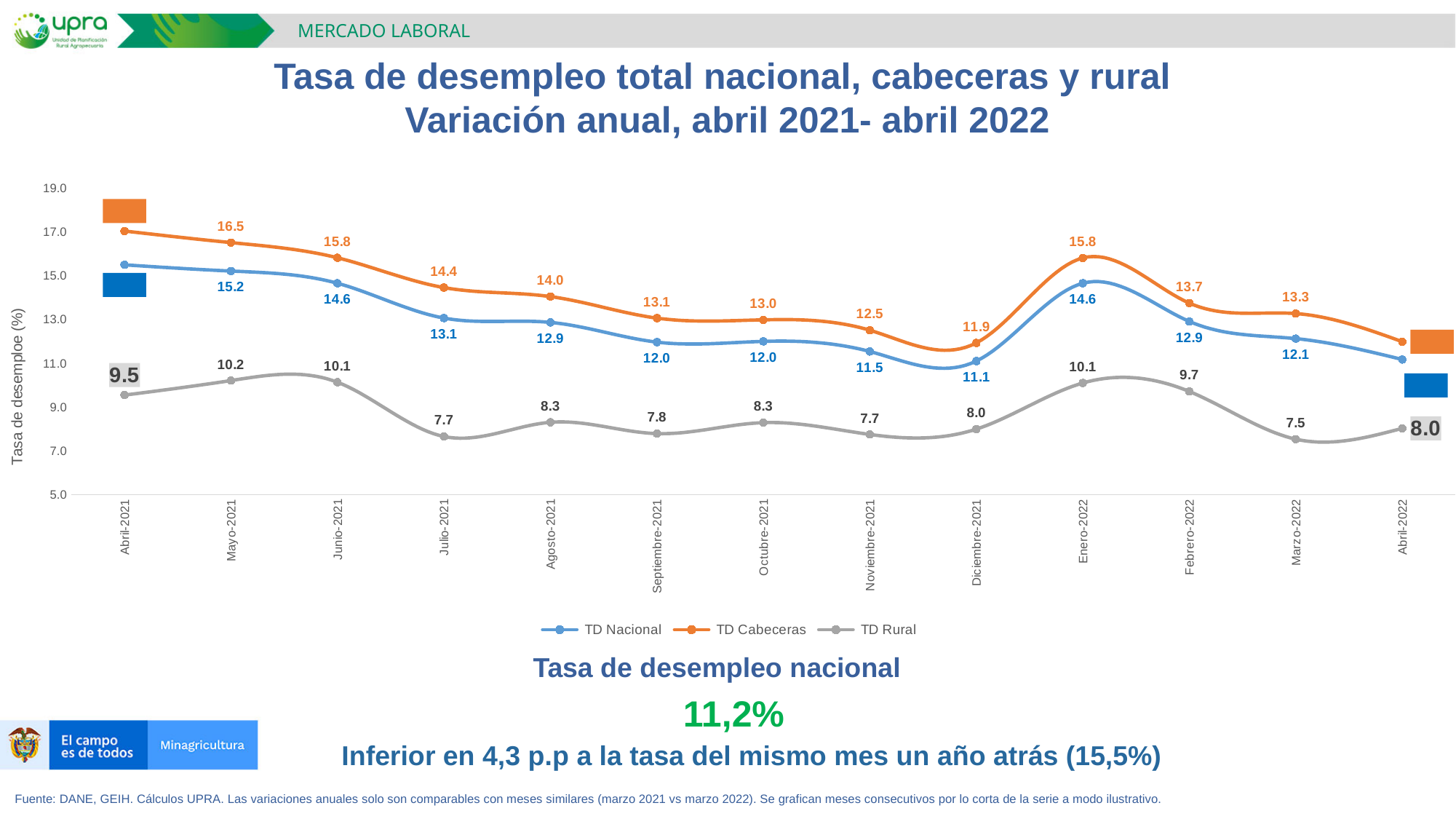
What is the TD Cabeceras value for Mayo-2021? 16.5 Does the TD Nacional series rise or fall from Abril-2021 to Diciembre-2021? fall What is the difference between the TD Cabeceras values for Enero-2022 and Febrero-2022? 2.1 What kind of chart is shown on the slide? line chart What is the TD Rural value for Marzo-2022? 7.5 In which month does the TD Nacional series reach its lowest value? Diciembre-2021 Is the TD Cabeceras value for Abril-2021 greater or less than 15.0? greater What is the TD Nacional value for Diciembre-2021? 11.1 How many series does the legend list? 3 How many months are shown on the x axis? 13 Which is larger for TD Rural: Agosto-2021 or Septiembre-2021? Agosto-2021 In which month does the TD Rural series reach its highest value? Mayo-2021